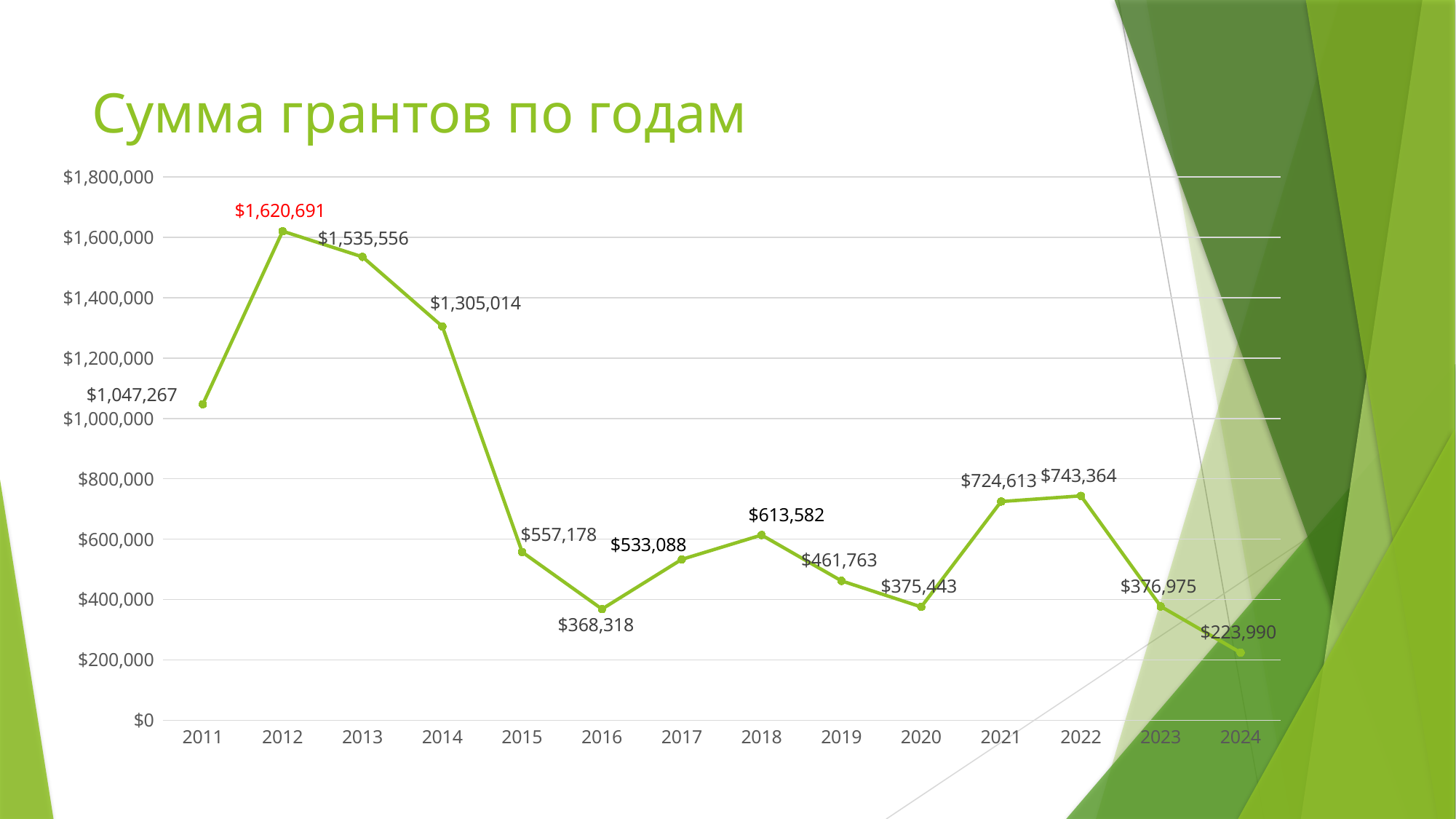
What is the grant amount for 2024? $223,990 What is the grant amount for 2016? $368,318 Does the grant amount rise or fall from 2012 to 2016? fall Which year has the lowest grant amount? 2024 Which year has a larger grant amount, 2018 or 2019? 2018 What is the grant amount for 2012? $1,620,691 What is the difference between the grant amounts for 2012 and 2011? $573,424 How many years are plotted on the chart? 14 What is the difference between the grant amounts for 2022 and 2021? $18,751 What type of chart is shown on the slide? line chart Which year has the highest grant amount? 2012 What is the title of the chart? Сумма грантов по годам